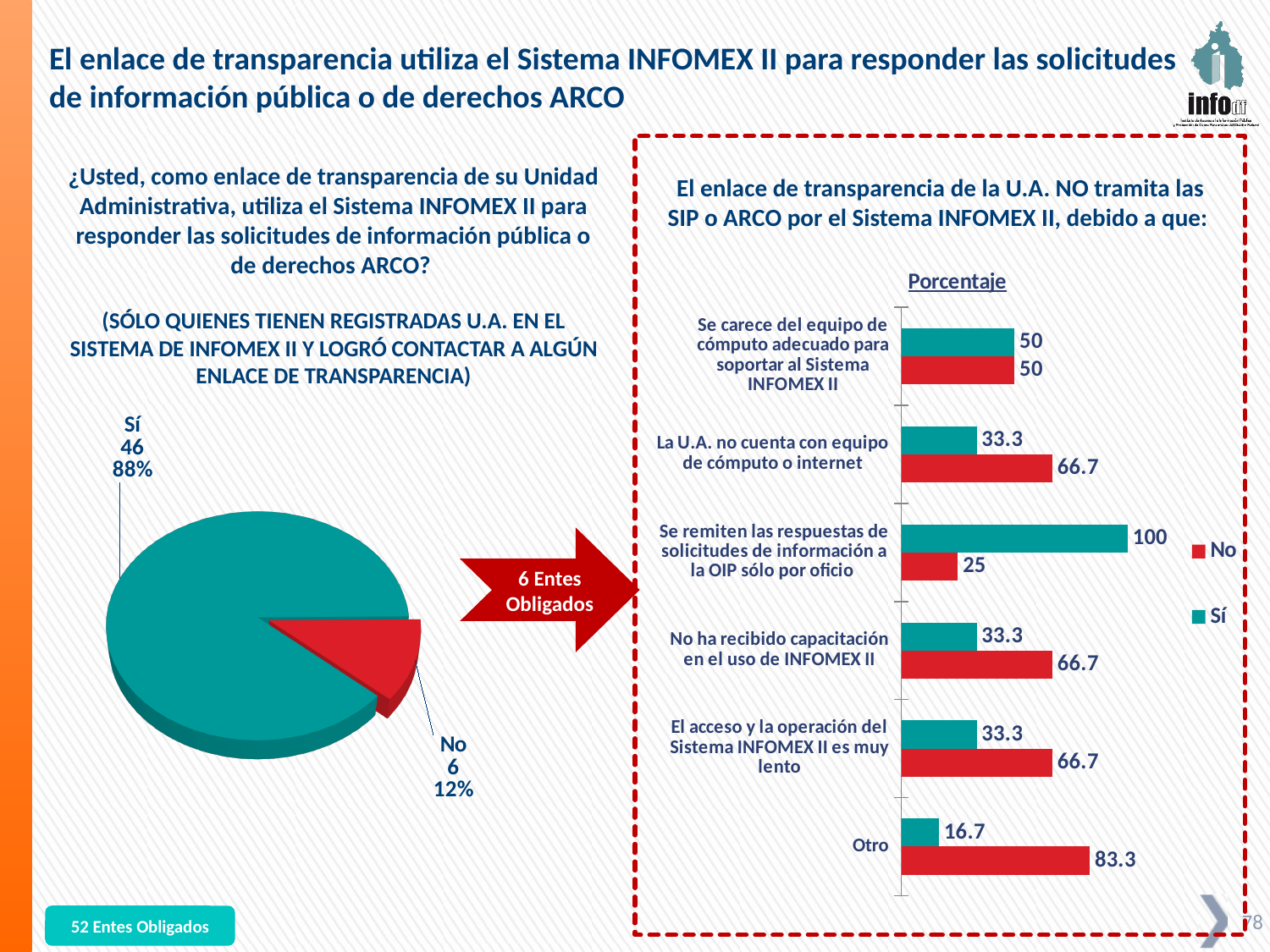
How many series does the legend of the bar chart on the right list? 2 In the pie chart on the left, which slice is larger, "Sí" or "No"? Sí In the bar chart on the right, what is the "Sí" value for "Se remiten las respuestas de solicitudes de información a la OIP sólo por oficio"? 100 In the bar chart on the right, what is the difference between the "No" and "Sí" values for "La U.A. no cuenta con equipo de cómputo o internet"? 33.4 In the bar chart on the right, which category has the lowest "Sí" value? Otro In the bar chart on the right, what is the "No" value for "Otro"? 83.3 What kind of chart is shown on the right side of the slide? Bar chart In the pie chart on the left, how many respondents answered "No"? 6 What kind of chart is shown on the left side of the slide? Pie chart In the bar chart on the right, which category has the highest "Sí" value? Se remiten las respuestas de solicitudes de información a la OIP sólo por oficio In the pie chart on the left, what percentage of respondents answered "Sí"? 88% How many categories are shown in the bar chart on the right? 6